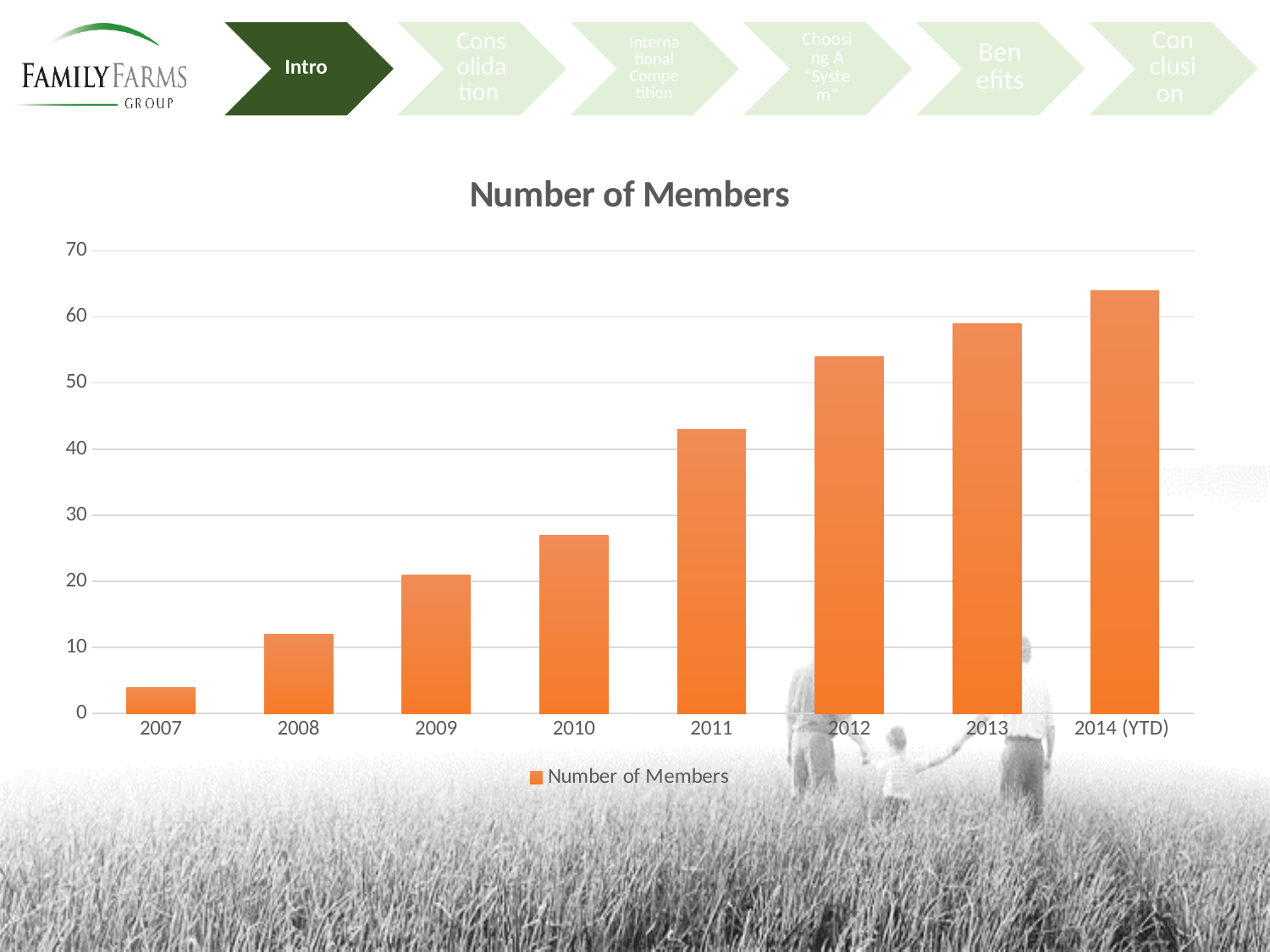
Does the number of members rise or fall from 2007 to 2014 (YTD)? rise Which year has more members, 2010 or 2012? 2012 What is the title of the chart? Number of Members Is the number of members in 2007 greater or less than 10? less Is the number of members in 2011 greater or less than 40? greater How many series does the chart's legend list? 1 Which year has the highest number of members? 2014 (YTD) Which year has the lowest number of members? 2007 Is the number of members in 2009 greater or less than 30? less How many years (categories) are shown on the x axis of the chart? 8 What type of chart is shown on the slide? bar chart